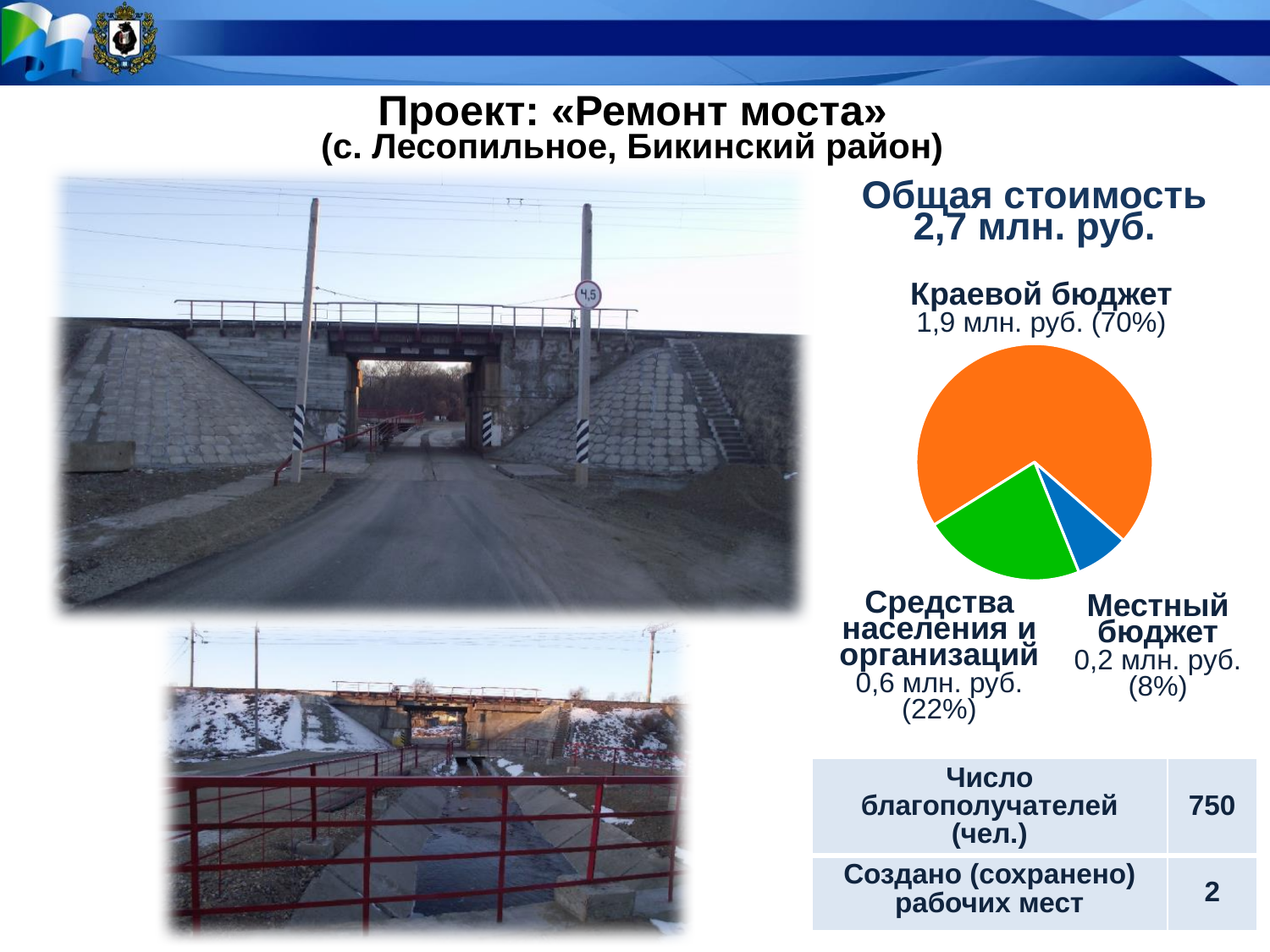
Which is larger, Средства населения и организаций or Местный бюджет? Средства населения и организаций What share of the pie does Краевой бюджет represent? 70% What is the value for Местный бюджет in the pie chart? 0,2 млн. руб. What share of the pie does Местный бюджет represent? 8% How many slices does the pie chart have? 3 What kind of chart is shown on the slide? pie chart What is the difference in млн. руб. between Краевой бюджет and Средства населения и организаций? 1,3 млн. руб. What is the value for Средства населения и организаций in the pie chart? 0,6 млн. руб. Which slice of the pie chart is the largest? Краевой бюджет What is the value for Краевой бюджет in the pie chart? 1,9 млн. руб. What colour is the Краевой бюджет slice in the pie chart? orange Which slice of the pie chart is the smallest? Местный бюджет